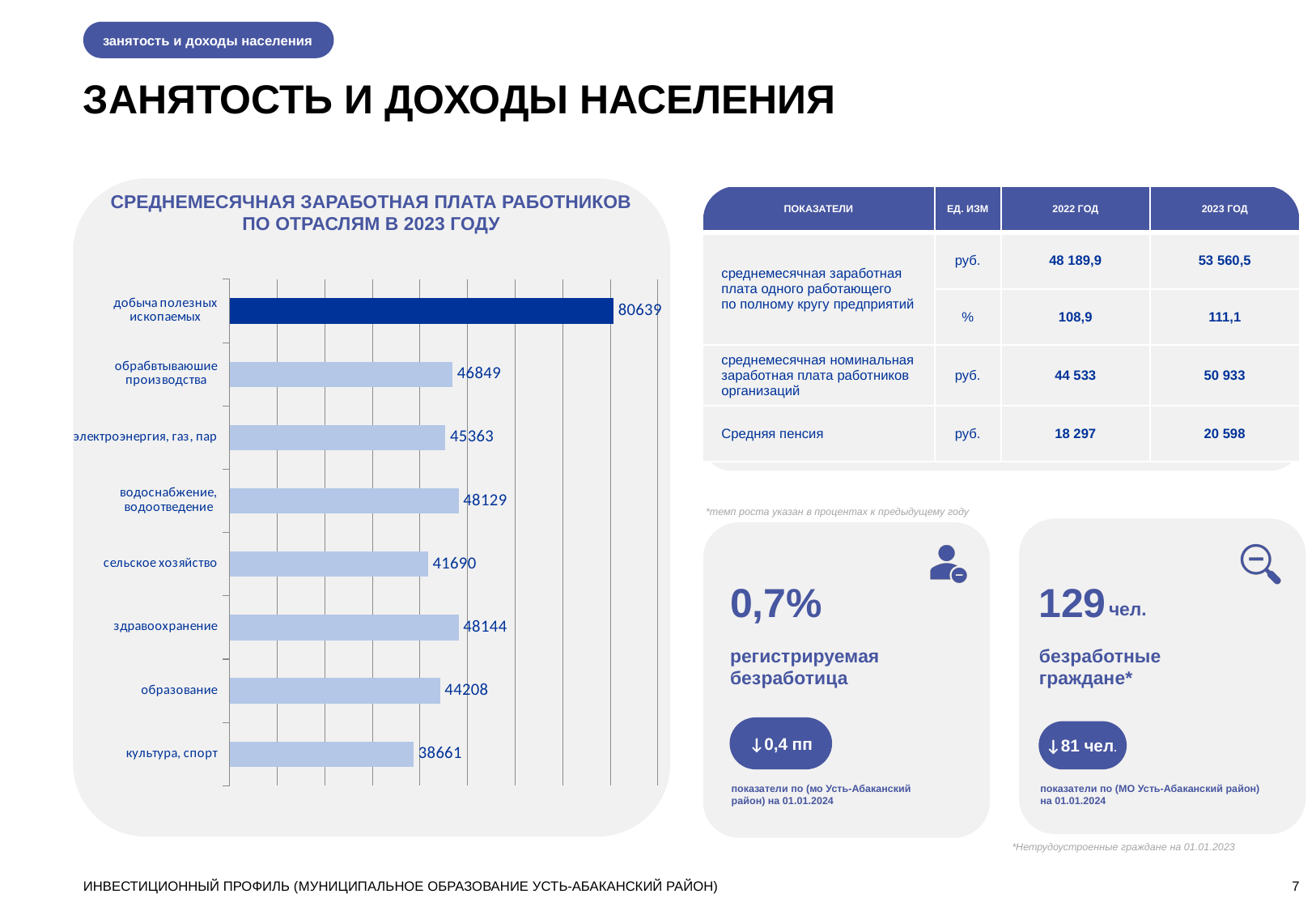
What is the difference between the values for добыча полезных ископаемых and культура, спорт? 41978 What is the difference between the values for здравоохранение and водоснабжение, водоотведение? 15 Which industry has the highest average monthly salary in the chart? добыча полезных ископаемых Which is larger: the value for обрабатывающие производства or for сельское хозяйство? обрабатывающие производства What type of chart is used to show average monthly salary by industry? bar chart What value is shown for культура, спорт? 38661 What is the average monthly salary shown for добыча полезных ископаемых? 80639 How many industries are shown in the chart? 8 What value is shown for здравоохранение? 48144 Which industry has the lowest average monthly salary in the chart? культура, спорт What value is shown for сельское хозяйство? 41690 Which bar in the chart is coloured dark blue, unlike the others? добыча полезных ископаемых